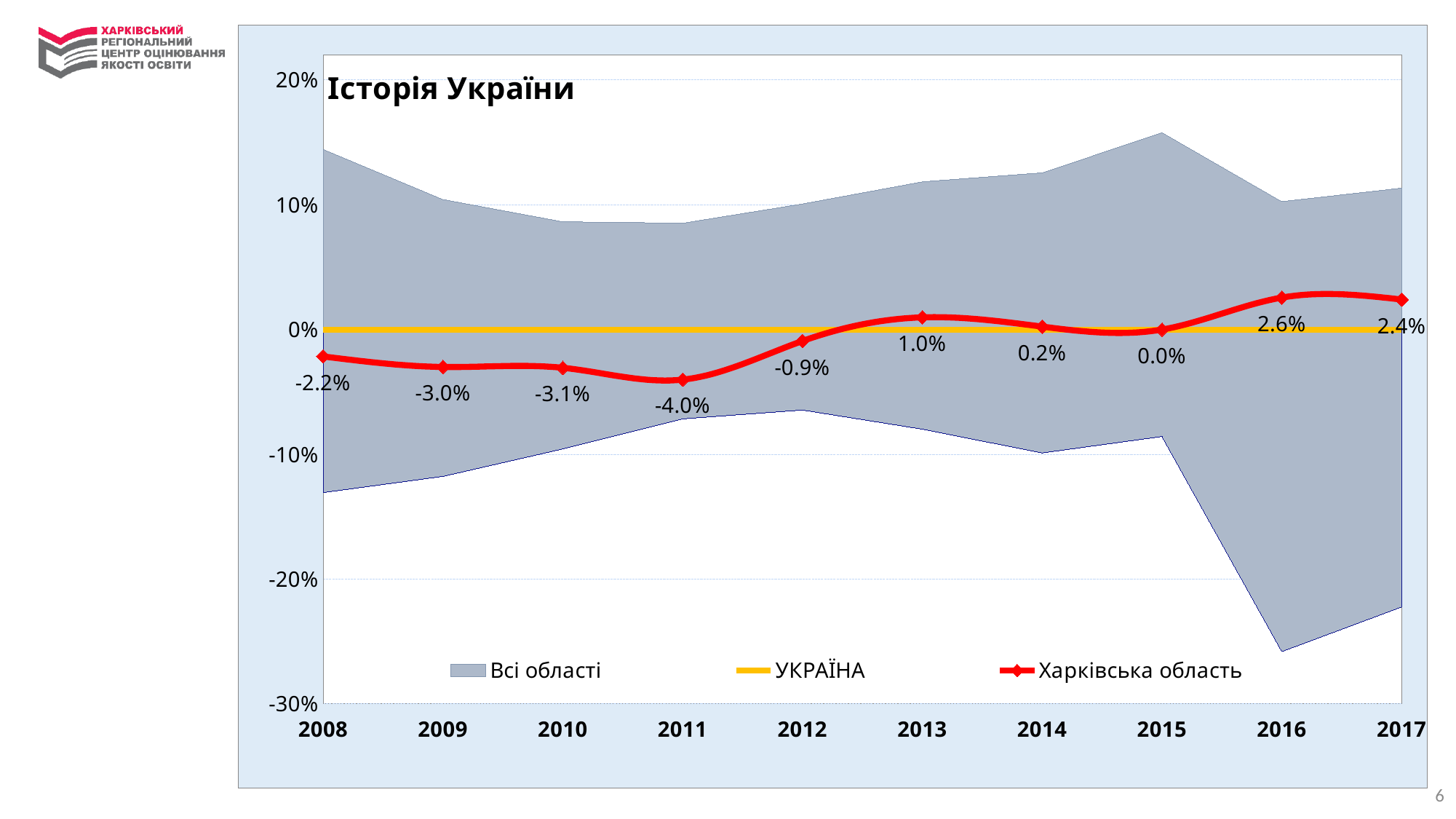
What is the value for Харківська область in 2011? -4.0% Is the upper edge of the Всі області band in 2015 greater or less than 10%? greater What is the difference between the Харківська область values in 2016 and 2011? 6.6 percentage points How many series does the legend list? 3 Does the Харківська область line rise or fall from 2011 to 2013? Rise In which year is the value for Харківська область the lowest? 2011 Which is larger for Харківська область: the value in 2009 or the value in 2014? 2014 How many years are shown on the x axis? 10 What is the value for Харківська область in 2013? 1.0% In which year is the value for Харківська область the highest? 2016 What is the value for Харківська область in 2016? 2.6% What kind of chart is this? Line chart with a shaded area band